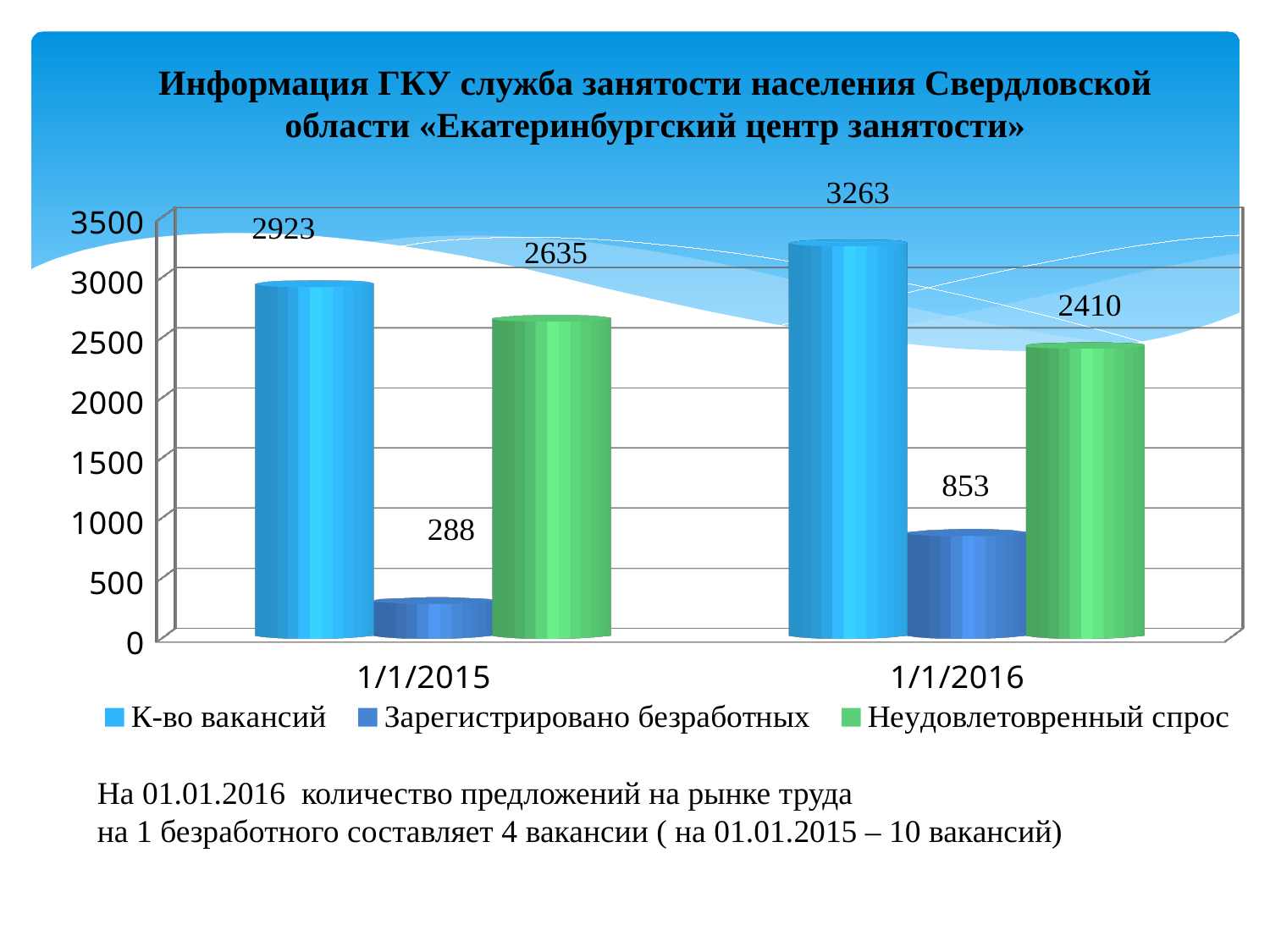
What is the difference between Неудовлетоврренный спрос for 1/1/2015 and 1/1/2016? 225 What kind of chart is shown on the slide? bar chart Which is larger: Зарегистрировано безработных for 1/1/2016 or for 1/1/2015? 1/1/2016 What is the value of Зарегистрировано безработных for 1/1/2016? 853 What is the difference between К-во вакансий for 1/1/2016 and 1/1/2015? 340 Which category has the lowest value for Зарегистрировано безработных? 1/1/2015 Is the value of Зарегистрировано безработных for 1/1/2016 greater or less than 1000? less What is the value of К-во вакансий for 1/1/2015? 2923 What is the value of Неудовлетоврренный спрос for 1/1/2015? 2635 Which category has the highest value for К-во вакансий? 1/1/2016 How many categories are shown on the x axis? 2 How many series does the legend list? 3